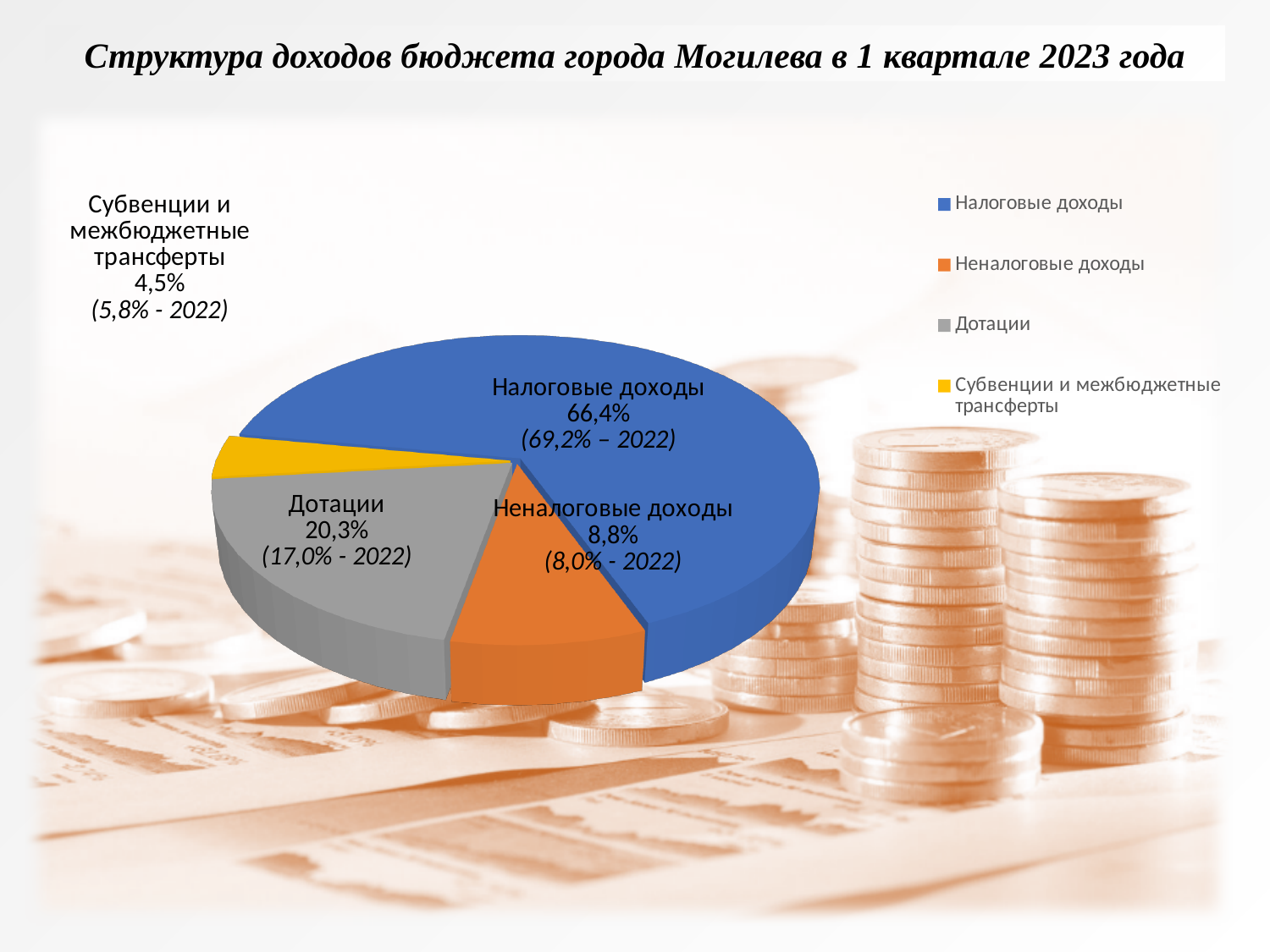
What was the share of Налоговые доходы in 2022, as shown in parentheses on the chart? 69,2% Which is larger in 2023: Дотации or Неналоговые доходы? Дотации What share of the pie does Неналоговые доходы have in 1 квартал 2023? 8,8% Which category has the smallest slice of the pie? Субвенции и межбюджетные трансферты How many categories does the pie chart show? 4 What type of chart is shown on the slide? Pie chart What share of the pie does Налоговые доходы have in 1 квартал 2023? 66,4% What share of the pie does Дотации have in 1 квартал 2023? 20,3% What share of the pie does Субвенции и межбюджетные трансферты have in 1 квартал 2023? 4,5% What was the share of Дотации in 2022, as shown in parentheses on the chart? 17,0% Which category has the largest slice of the pie? Налоговые доходы What is the difference in percentage points between the 2023 shares of Дотации and Неналоговые доходы? 11,5